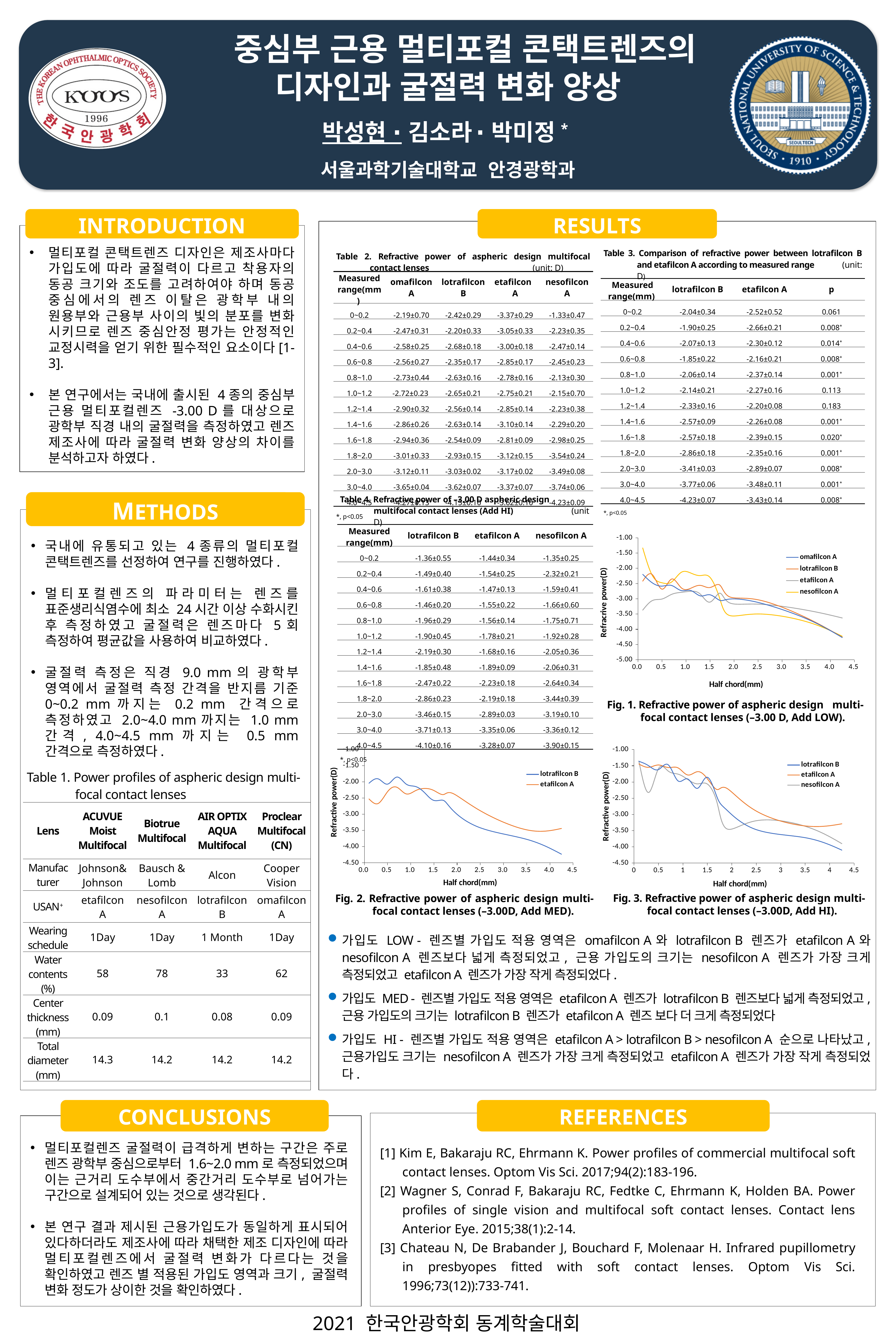
In Fig. 2 (Add MED), at a half chord of 3.0 mm, which series has the higher refractive power, lotrafilcon B or etafilcon A? etafilcon A In Fig. 3 (Add HI), is the value for nesofilcon A at a half chord of 2.0 mm greater or less than -3.00? less In Fig. 1 (Add LOW), do the refractive power values generally rise or fall as half chord increases from 0 to 4.5 mm? fall In Fig. 1 (Add LOW), is the value for nesofilcon A at a half chord of 0 mm greater or less than -2.00? greater What kind of chart is Fig. 1 (Refractive power of aspheric design multifocal contact lenses, -3.00 D, Add LOW)? line chart How many series does the legend of Fig. 3 (Add HI) list? 3 What is the x-axis title of Fig. 2 (Add MED)? Half chord(mm) How many series does the legend of Fig. 2 (Add MED) list? 2 In Fig. 1 (Add LOW), at a half chord of 1.0 mm, which series has the higher refractive power, nesofilcon A or etafilcon A? nesofilcon A How many series does the legend of Fig. 1 (Add LOW) list? 4 In Fig. 2 (Add MED), is the value for etafilcon A at a half chord of 4.0 mm greater or less than -4.00? greater In Fig. 1 (Add LOW), which series is shown in yellow? nesofilcon A